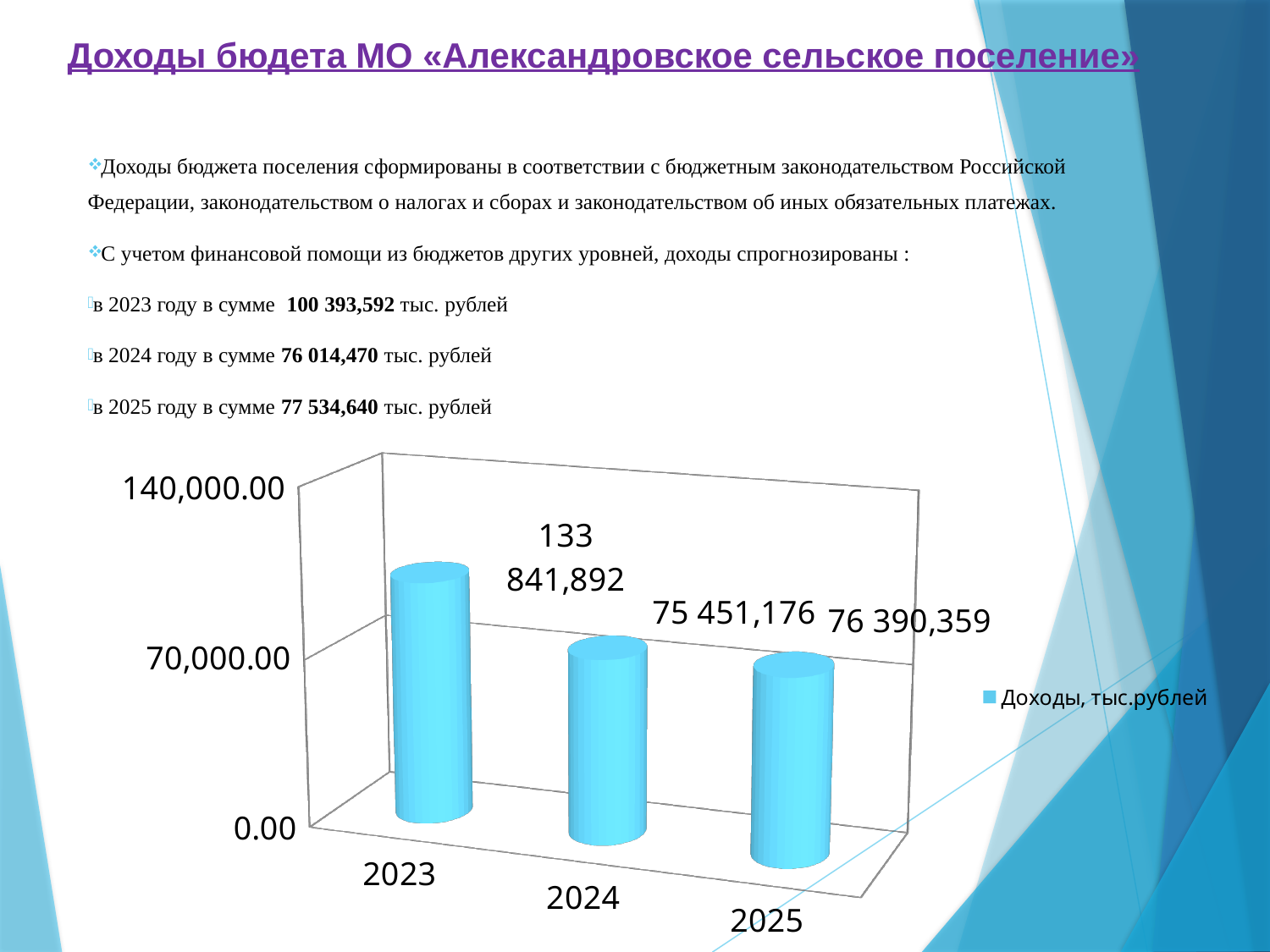
Which year has the lowest value in the chart? 2024 Is the value for 2023 greater or less than 70,000.00? greater Which is larger in the chart, the value for 2024 or the value for 2025? 2025 What is the difference between the labelled values for 2025 and 2024? 939,183 What value is labelled for 2023 in the chart? 133 841,892 What value is labelled for 2024 in the chart? 75 451,176 What value is labelled for 2025 in the chart? 76 390,359 What kind of chart is shown on the slide? Bar chart Is the value for 2025 greater or less than 140,000.00? less How many series does the chart legend list? 1 How many years are shown on the x axis of the chart? 3 Which year has the highest value in the chart? 2023